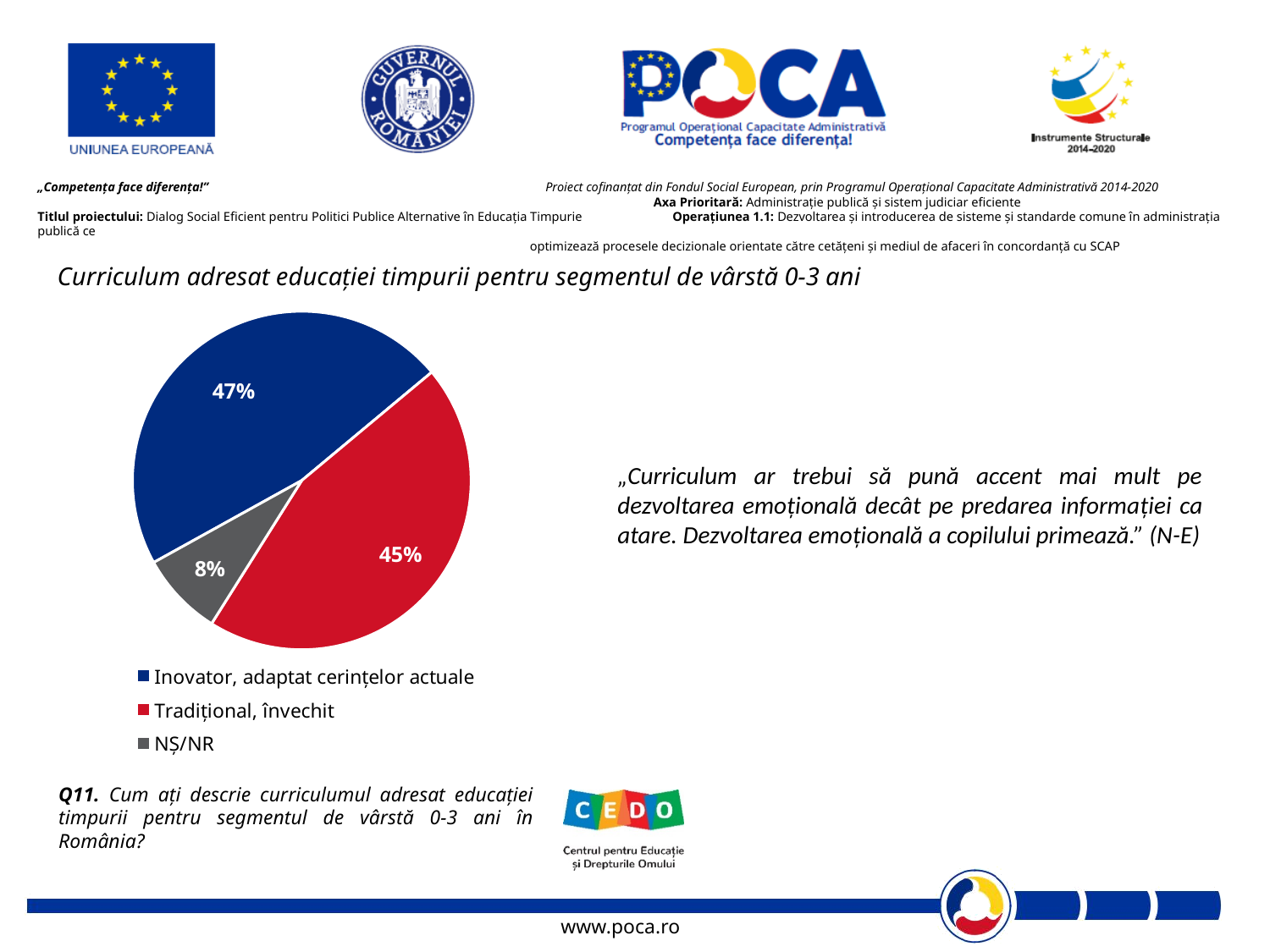
What colour is the slice for "Tradițional, învechit"? Red Which category has the smallest share of the pie? NȘ/NR Which is larger: the share for "Tradițional, învechit" or the share for "NȘ/NR"? Tradițional, învechit What percentage of respondents described the curriculum as "Tradițional, învechit"? 45% What is the title of the chart? Curriculum adresat educației timpurii pentru segmentul de vârstă 0-3 ani What type of chart is shown on the slide? Pie chart What percentage of respondents described the curriculum as "Inovator, adaptat cerințelor actuale"? 47% How many categories does the pie chart show? 3 What percentage of respondents answered "NȘ/NR"? 8% What is the difference in percentage points between "Inovator, adaptat cerințelor actuale" and "Tradițional, învechit"? 2 percentage points What is the difference in percentage points between "Tradițional, învechit" and "NȘ/NR"? 37 percentage points Which category has the largest share of the pie? Inovator, adaptat cerințelor actuale